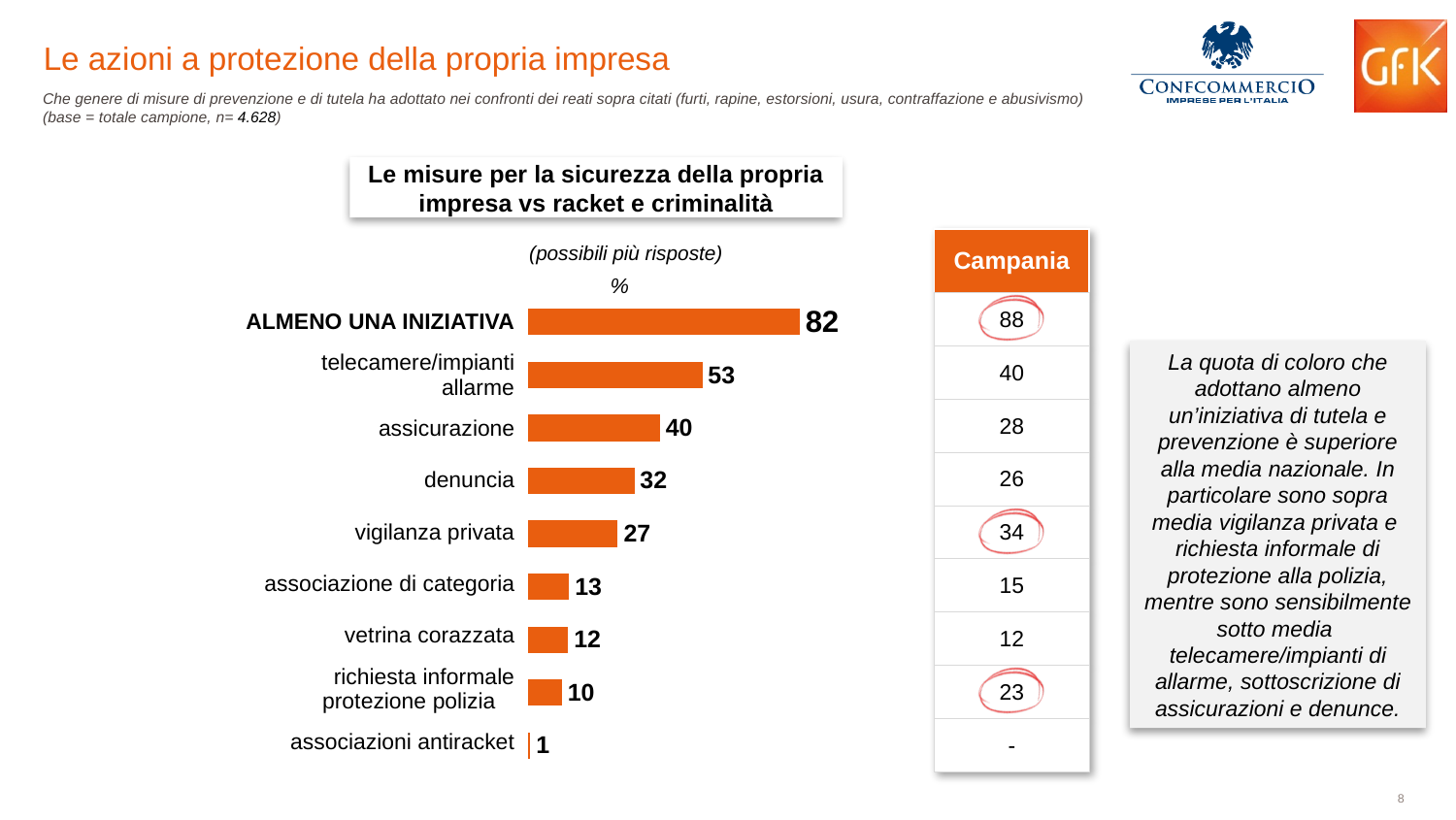
Which is larger in the bar chart: 'associazione di categoria' or 'vetrina corazzata'? associazione di categoria What is the difference between the values for 'ALMENO UNA INIZIATIVA' and 'assicurazione'? 42 Which category has the highest value in the bar chart? ALMENO UNA INIZIATIVA Which category has the lowest value in the bar chart? associazioni antiracket How many categories are shown in the bar chart? 9 What type of chart is shown on the slide? bar chart What is the difference between the values for 'telecamere/impianti allarme' and 'denuncia'? 21 What is the value for 'telecamere/impianti allarme' in the bar chart? 53 What is the value for 'vigilanza privata' in the bar chart? 27 What is the value for 'richiesta informale protezione polizia' in the bar chart? 10 What is the title of the chart? Le misure per la sicurezza della propria impresa vs racket e criminalità What is the value for 'assicurazione' in the bar chart? 40